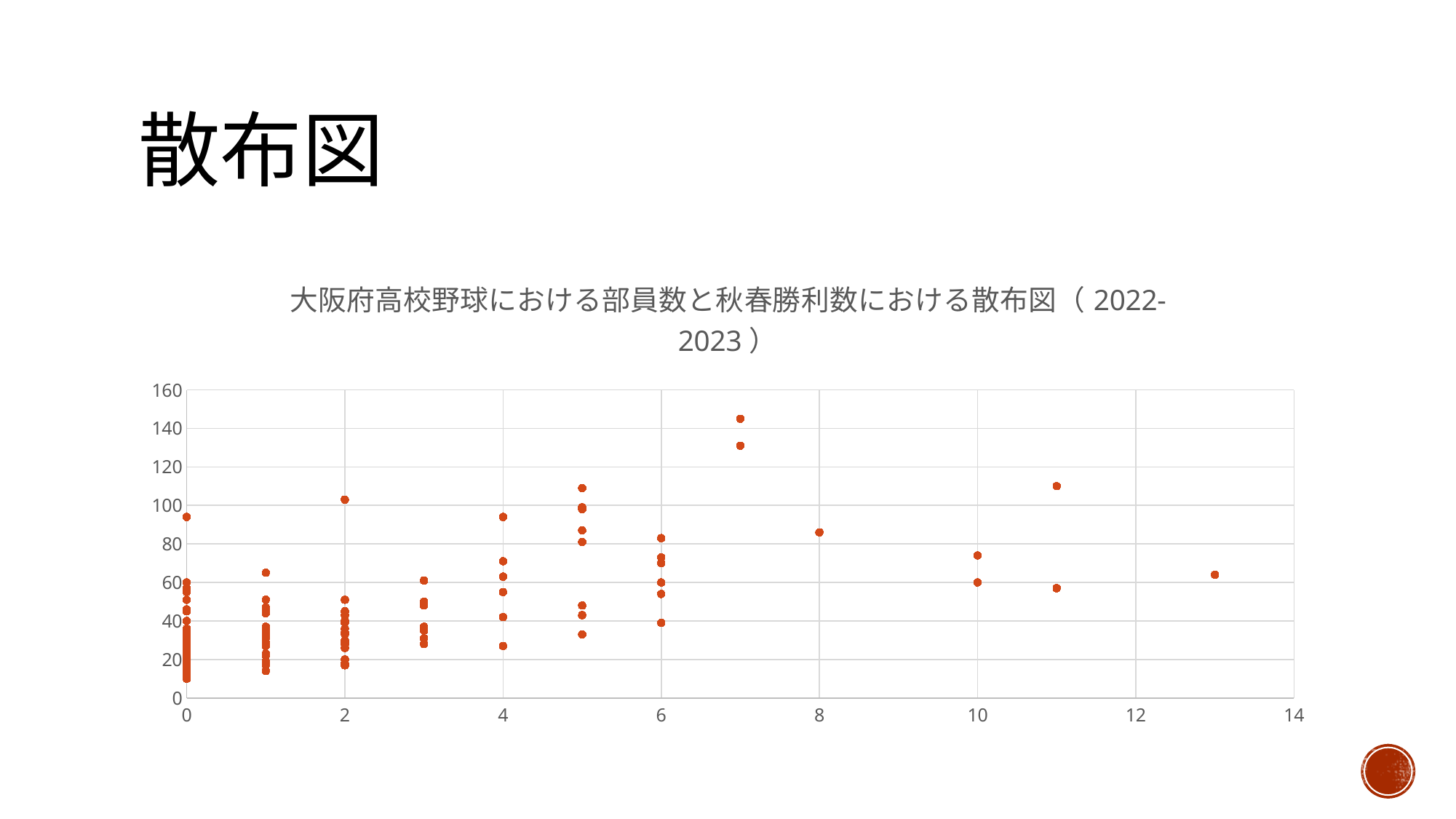
What kind of chart is shown on the slide? scatter chart Is the point plotted at x = 13 greater or less than 80? less How many points are plotted at x = 7? 2 How many points are plotted at x = 8? 1 At which x value is the highest point on the chart plotted? 7 Is the highest point plotted at x = 7 greater or less than 140? greater Is the highest point plotted at x = 11 greater or less than 100? greater What is the title of the chart? 大阪府高校野球における部員数と秋春勝利数における散布図（2022-2023） Which is higher: the point at x = 8 or the point at x = 13? the point at x = 8 What is the highest value shown on the vertical axis? 160